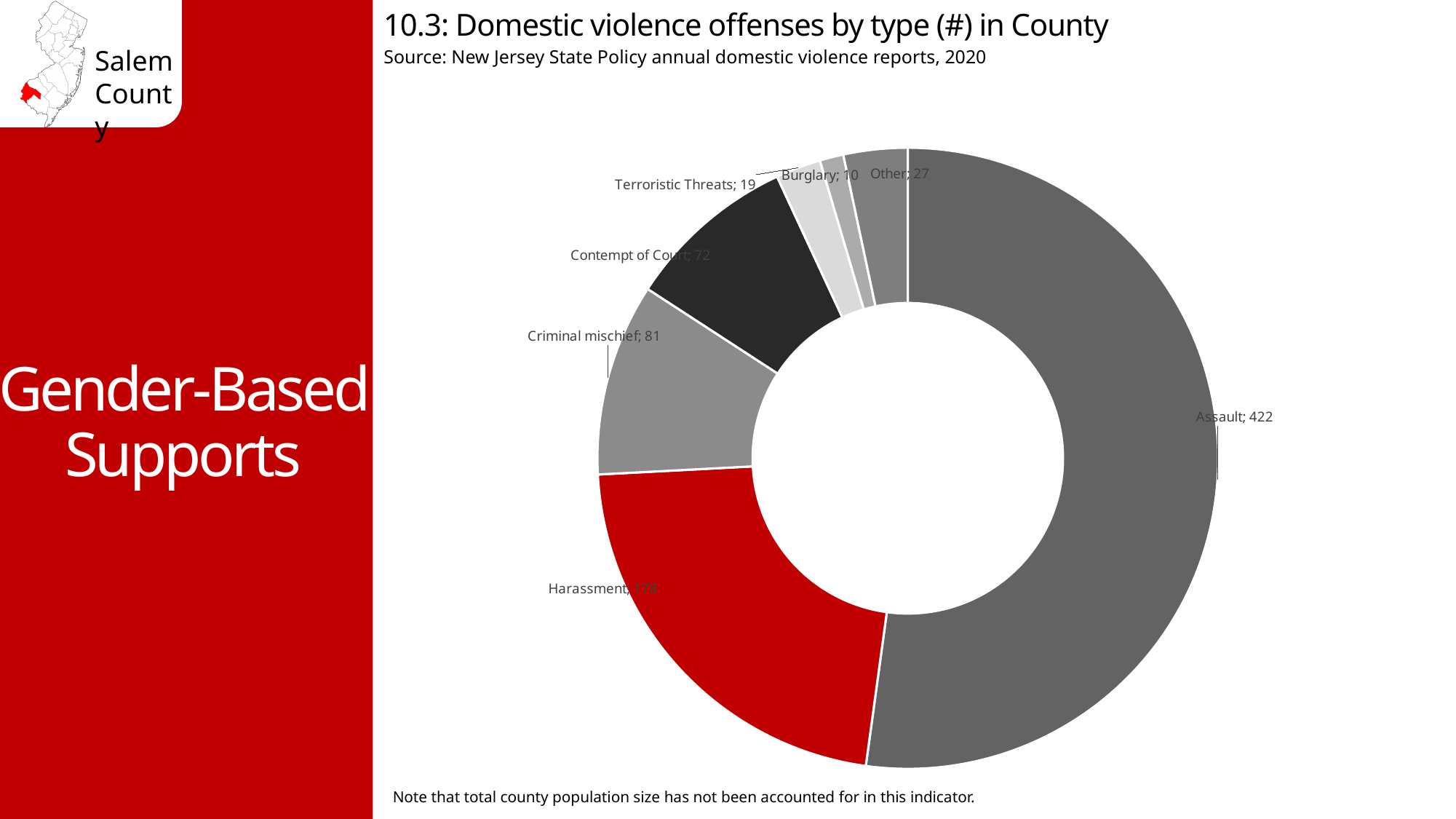
How many offense types are shown in the chart? 7 Which offense type has the smallest slice in the chart? Burglary Which offense type has the largest slice in the chart? Assault What is the difference between the Other and Terroristic Threats values? 8 What value is shown for Burglary? 10 What kind of chart is used on this slide? Pie chart (doughnut) What is the difference between the Assault and Harassment values? 244 How many Harassment offenses does the chart show? 178 What value is shown for Contempt of Court? 72 What value is shown for Criminal mischief? 81 What is the number of Assault offenses shown in the chart? 422 Which is larger, Criminal mischief or Contempt of Court? Criminal mischief